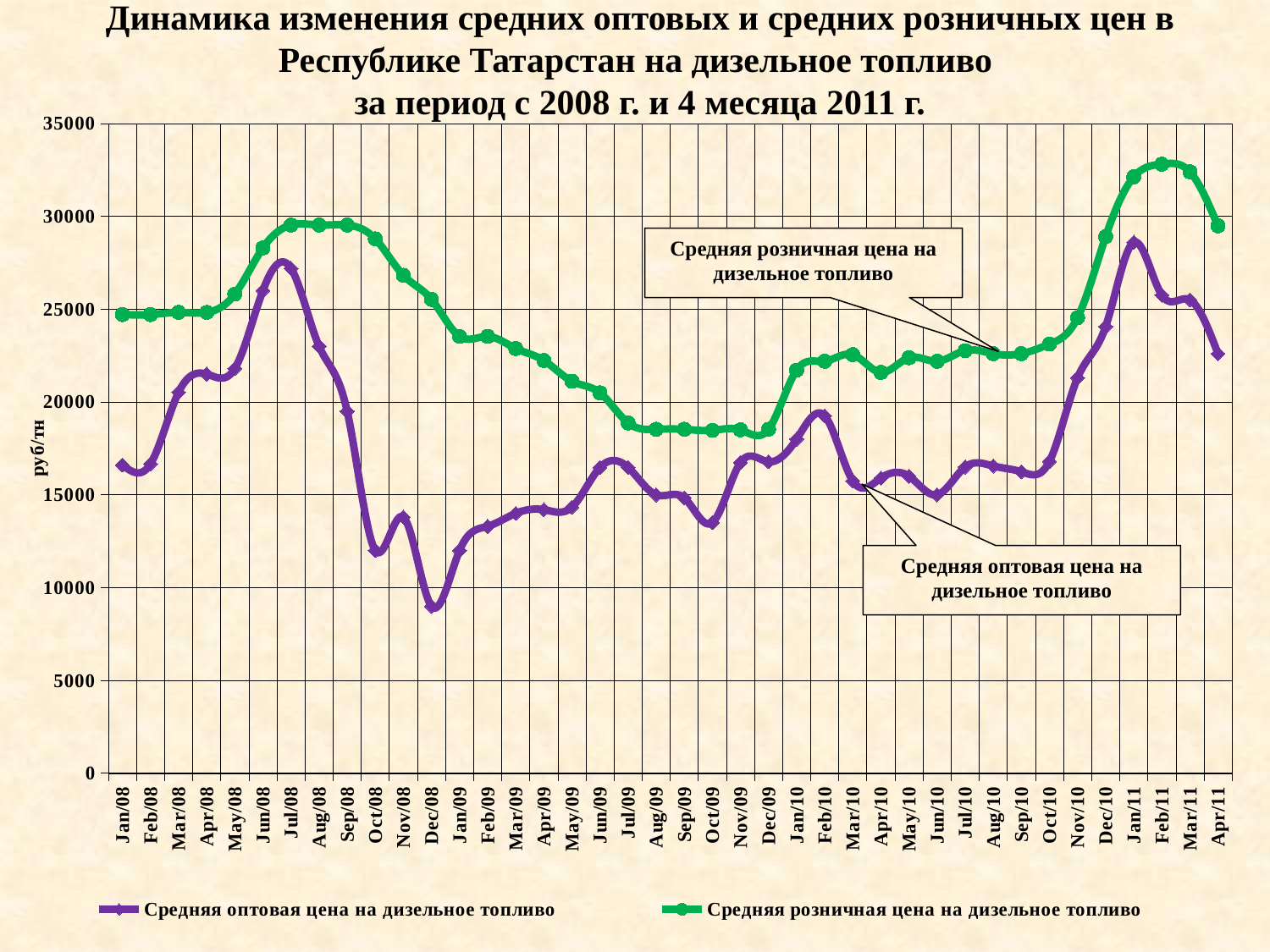
In which month does the wholesale price series (Средняя оптовая цена) reach its lowest point? Dec/08 Is the value of the wholesale price series (Средняя оптовая цена) for Dec/08 greater or less than 10000? less Does the wholesale price series (Средняя оптовая цена) rise or fall from Jan/11 to Apr/11? fall In which month does the wholesale price series (Средняя оптовая цена) reach its highest point? Jan/11 Is the value of the retail price series (Средняя розничная цена) for Aug/09 greater or less than 20000? less Is the value of the wholesale price series (Средняя оптовая цена) for Jan/11 greater or less than 25000? greater What colour is the line for the retail price series (Средняя розничная цена на дизельное топливо)? green How many monthly points are plotted along the x axis, from Jan/08 to Apr/11? 40 What kind of chart is shown on the slide? line chart Which series is higher in Jan/08, the wholesale price or the retail price? retail price (Средняя розничная цена) How many series does the legend list? 2